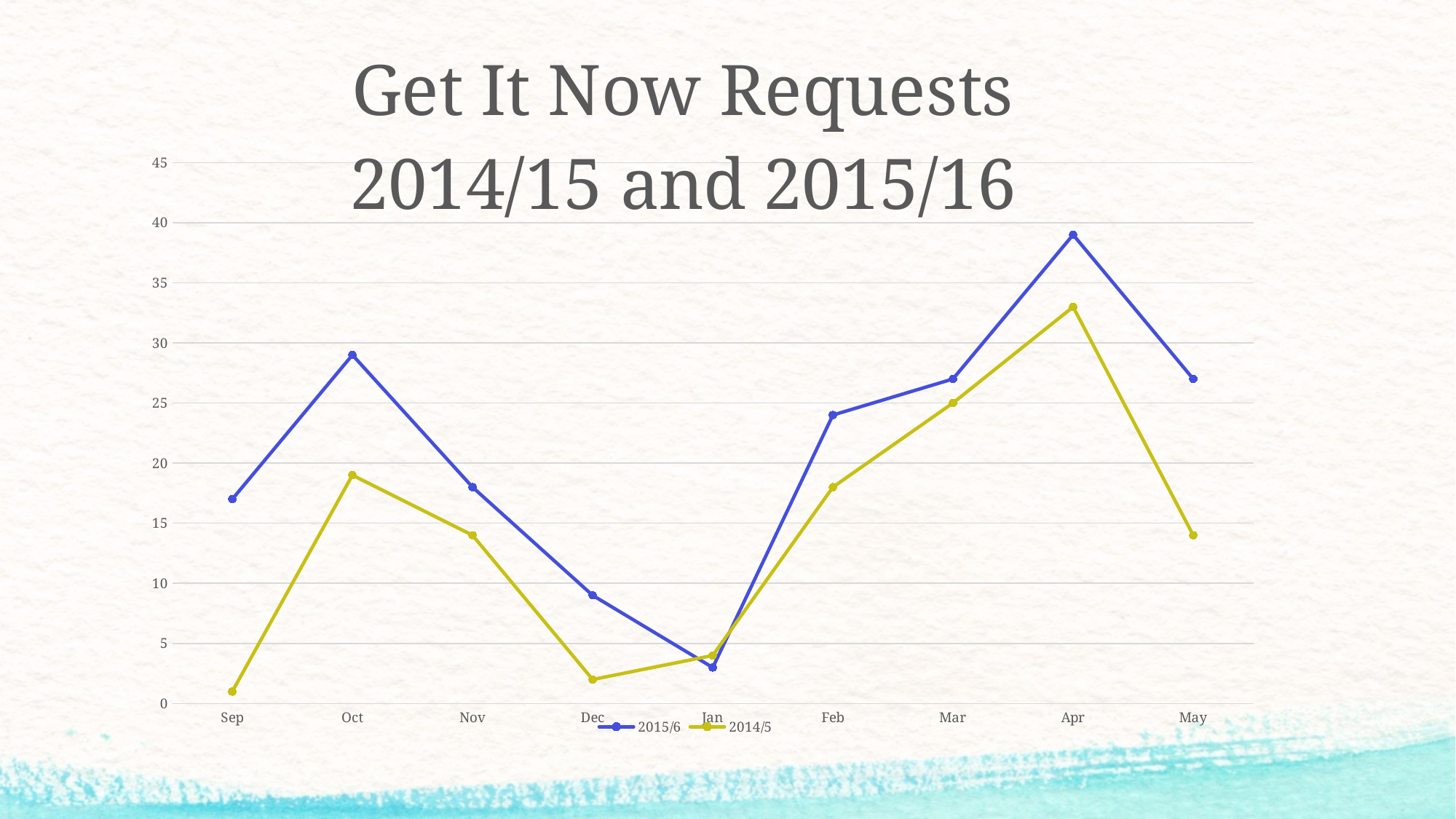
How many series does the legend list? 2 In which month is the 2014/5 series at its lowest? Sep In which month does the 2014/5 series reach its highest value? Apr In Oct, which series has the larger value, 2015/6 or 2014/5? 2015/6 Does the 2015/6 series rise or fall from Jan to Apr? rise How many months are plotted along the x axis? 9 Is the value for 2014/5 in Sep greater or less than 5? less What kind of chart is shown on the slide? line chart Is the value for 2015/6 in Apr greater or less than 35? greater Is the value for 2014/5 in Apr greater or less than 30? greater In which month does the 2015/6 series reach its highest value? Apr In which month is the 2015/6 series at its lowest? Jan